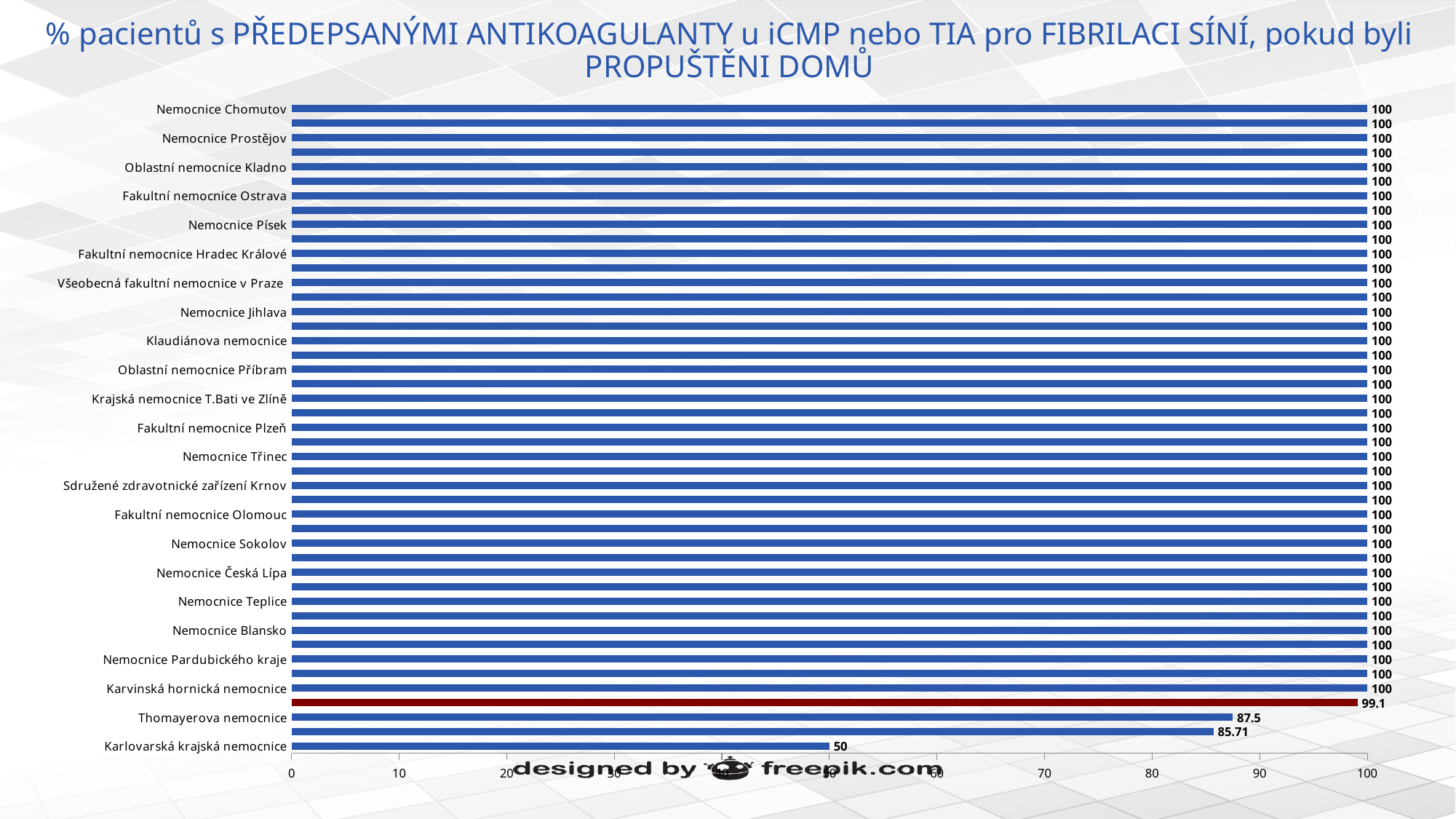
What is the value for Karlovarská krajská nemocnice? 50 What is the difference between the values for Thomayerova nemocnice and Karlovarská krajská nemocnice? 37.5 Which is larger, the value for Thomayerova nemocnice or the value for Karlovarská krajská nemocnice? Thomayerova nemocnice What is the value for Nemocnice Chomutov? 100 What is the value for Thomayerova nemocnice? 87.5 Which hospital has the lowest value? Karlovarská krajská nemocnice What is the value for Fakultní nemocnice Plzeň? 100 What is the difference between the values for Nemocnice Chomutov and Thomayerova nemocnice? 12.5 Is the value for Karlovarská krajská nemocnice greater or less than 60? less What colour is the bar labelled 99.1? red What kind of chart is shown on the slide? bar chart How many bars have a value below 100? 4